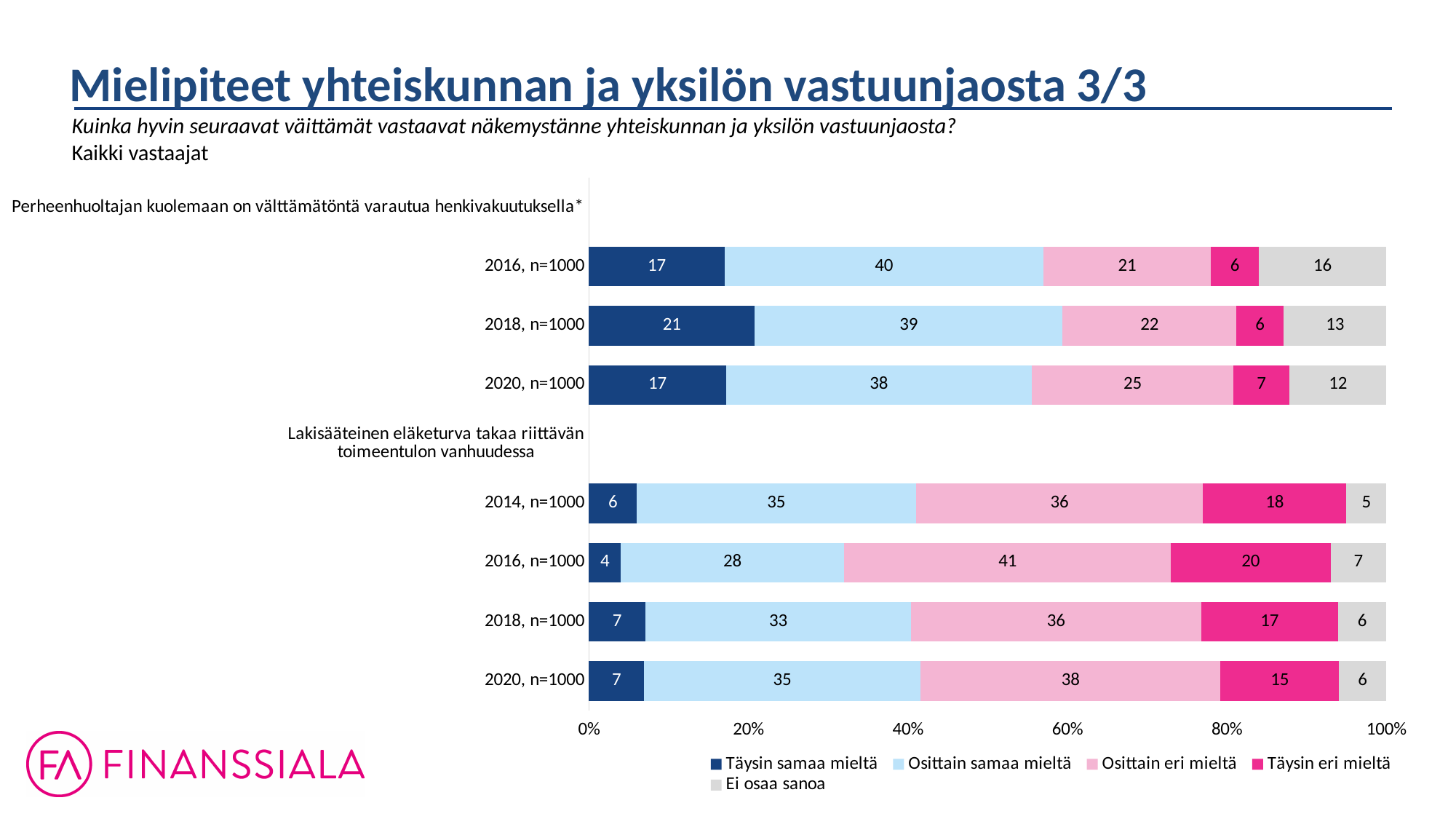
How many bars are plotted in the chart in total? 7 What is the value for "Ei osaa sanoa" in the 2020 bar under "Perheenhuoltajan kuolemaan on välttämätöntä varautua henkivakuutuksella*"? 12 What is the value for "Täysin samaa mieltä" in the 2018 bar under "Perheenhuoltajan kuolemaan on välttämätöntä varautua henkivakuutuksella*"? 21 Among the bars under "Lakisääteinen eläketurva takaa riittävän toimeentulon vanhuudessa", which year has the lowest "Täysin samaa mieltä" value? 2016, n=1000 What is the total of the 2018 bar under "Lakisääteinen eläketurva takaa riittävän toimeentulon vanhuudessa"? 99 What is the difference between the "Osittain samaa mieltä" values for 2016 and 2020 under "Perheenhuoltajan kuolemaan on välttämätöntä varautua henkivakuutuksella*"? 2 How many series does the legend list? 5 Which is larger: the "Osittain eri mieltä" value for 2014 or for 2020 under "Lakisääteinen eläketurva takaa riittävän toimeentulon vanhuudessa"? 2020 What is the value for "Osittain eri mieltä" in the 2016 bar under "Lakisääteinen eläketurva takaa riittävän toimeentulon vanhuudessa"? 41 Among the bars under "Lakisääteinen eläketurva takaa riittävän toimeentulon vanhuudessa", which year has the highest "Täysin eri mieltä" value? 2016, n=1000 What kind of chart is shown on the slide? Stacked bar chart Which legend entry is shown in dark blue? Täysin samaa mieltä